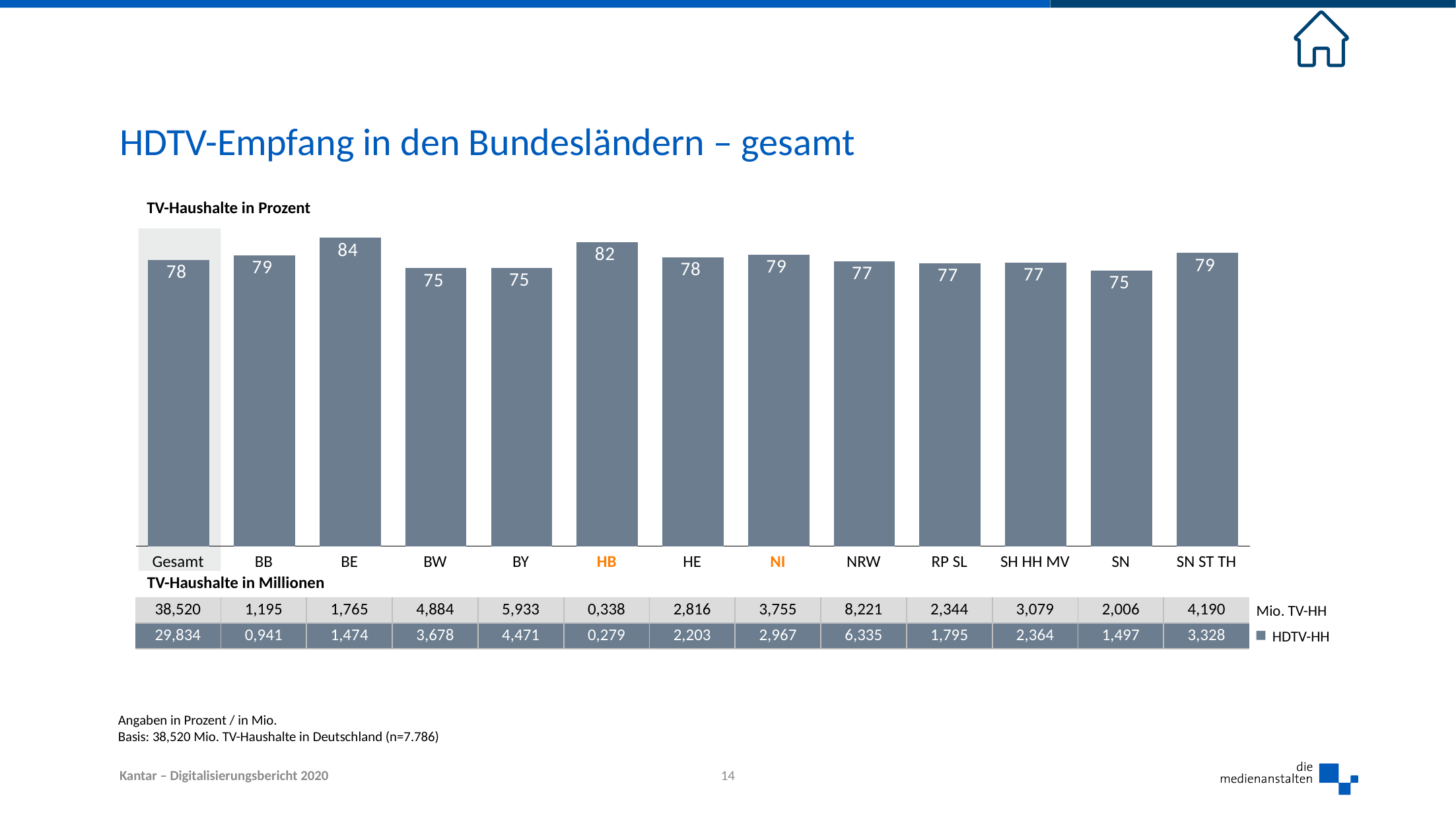
What is the HDTV reception percentage for HB? 82 How many bars are shown in the chart, including Gesamt? 13 What is the HDTV reception percentage for BE? 84 What is the difference in percentage points between BE and BW? 9 What is the title of the slide? HDTV-Empfang in den Bundesländern – gesamt What is the HDTV reception percentage for Gesamt? 78 Which Bundesland has the highest HDTV reception percentage? BE According to the table, how many million HDTV households (HDTV-HH) are there in Gesamt? 29,834 What type of chart is shown on the slide? bar chart Which has a higher HDTV reception percentage, HB or NRW? HB According to the table, how many million HDTV households (HDTV-HH) are there in BY? 4,471 According to the table, how many million TV households (Mio. TV-HH) are there in NRW? 8,221